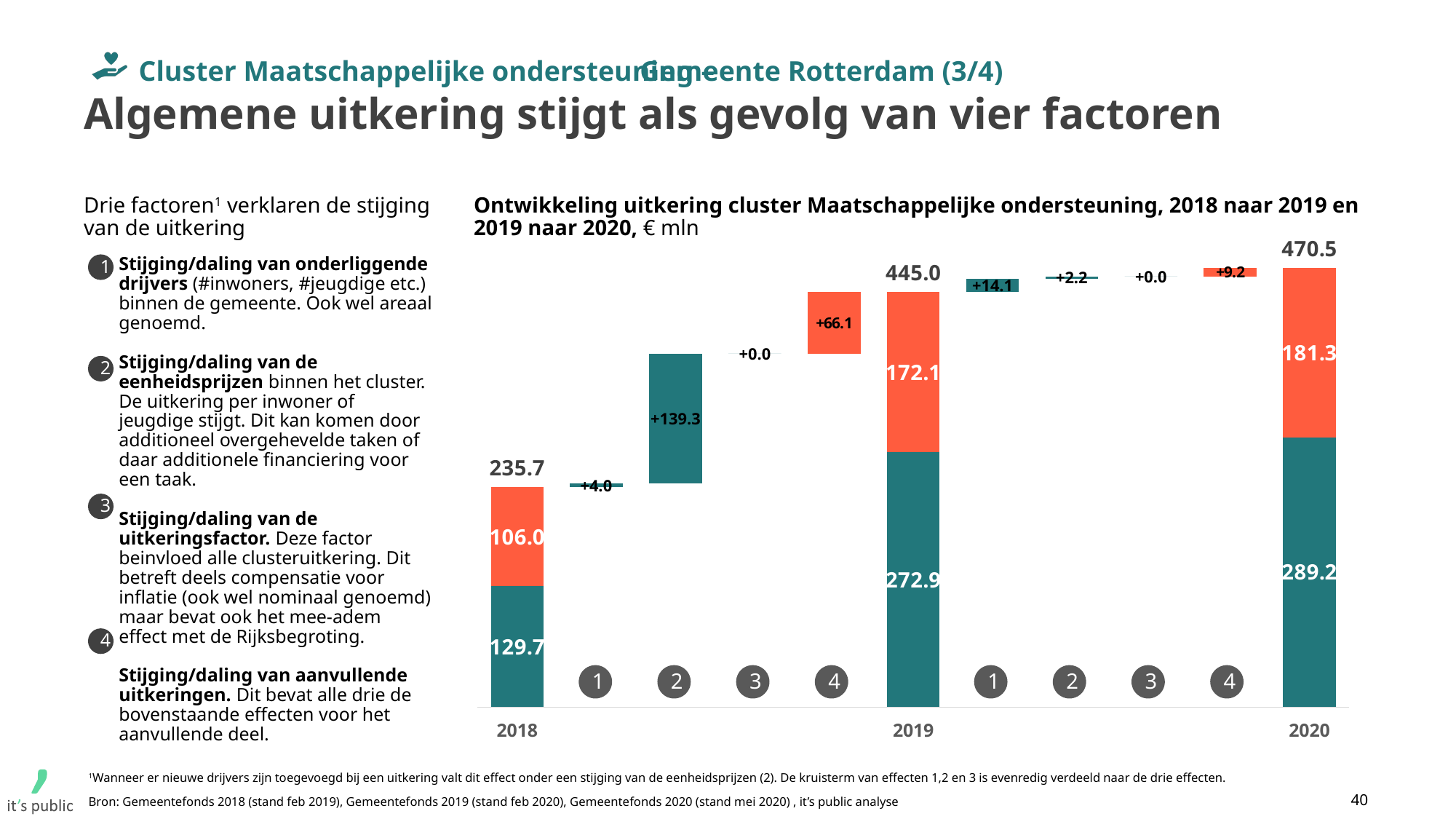
What is the difference between the 2019 total and the 2018 total? 209.3 Which year has the highest total value? 2020 What is the unit stated in the chart title? € mln Which is larger: the step 4 value between 2018 and 2019 or the step 4 value between 2019 and 2020? Step 4 between 2018 and 2019 (+66.1) What is the value of the teal (bottom) segment of the 2020 bar? 289.2 What is the value of step 2 (eenheidsprijzen) between 2018 and 2019? +139.3 What is the value of step 4 (aanvullende uitkeringen) between 2019 and 2020? +9.2 What is the total value shown for 2020? 470.5 What is the value of the orange (top) segment of the 2019 bar? 172.1 What is the total value shown for 2018? 235.7 Which year has the lowest total value? 2018 How many year totals are shown on the chart? 3